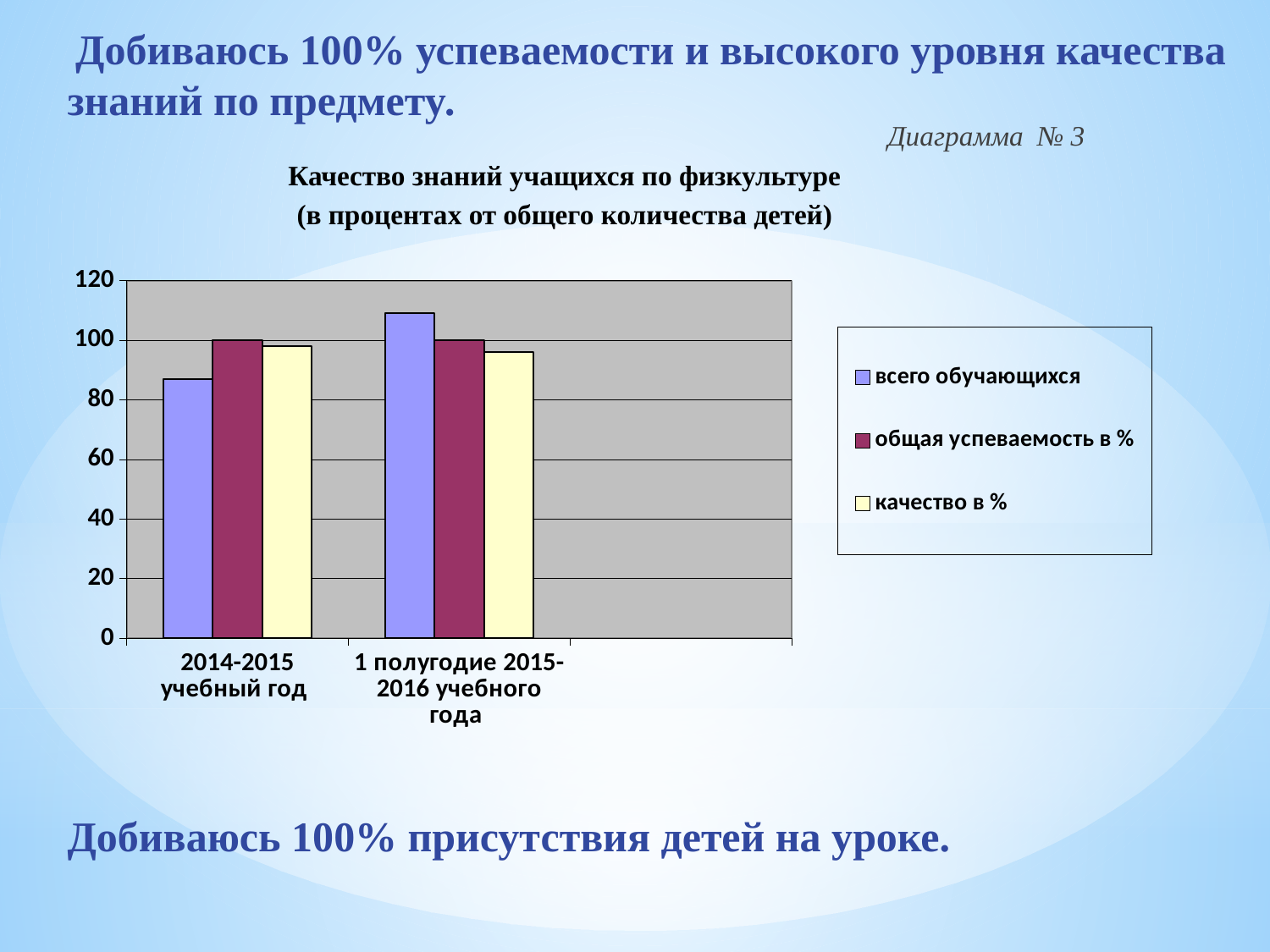
Is the value for всего обучающихся in 2014-2015 учебный год greater or less than 100? less Is the value for всего обучающихся in 1 полугодие 2015-2016 учебного года greater or less than 100? greater How many categories are shown on the x axis? 2 What kind of chart is shown on the slide? bar chart What is the title of the chart? Качество знаний учащихся по физкультуре (в процентах от общего количества детей) What is the value of общая успеваемость в % for 1 полугодие 2015-2016 учебного года? 100 Which series has the lowest value in 2014-2015 учебный год? всего обучающихся Is the value for качество в % in 2014-2015 учебный год greater or less than 80? greater Which category has the larger value for всего обучающихся: 2014-2015 учебный год or 1 полугодие 2015-2016 учебного года? 1 полугодие 2015-2016 учебного года How many series does the legend list? 3 Which series has the highest value in 1 полугодие 2015-2016 учебного года? всего обучающихся What is the value of общая успеваемость в % for 2014-2015 учебный год? 100